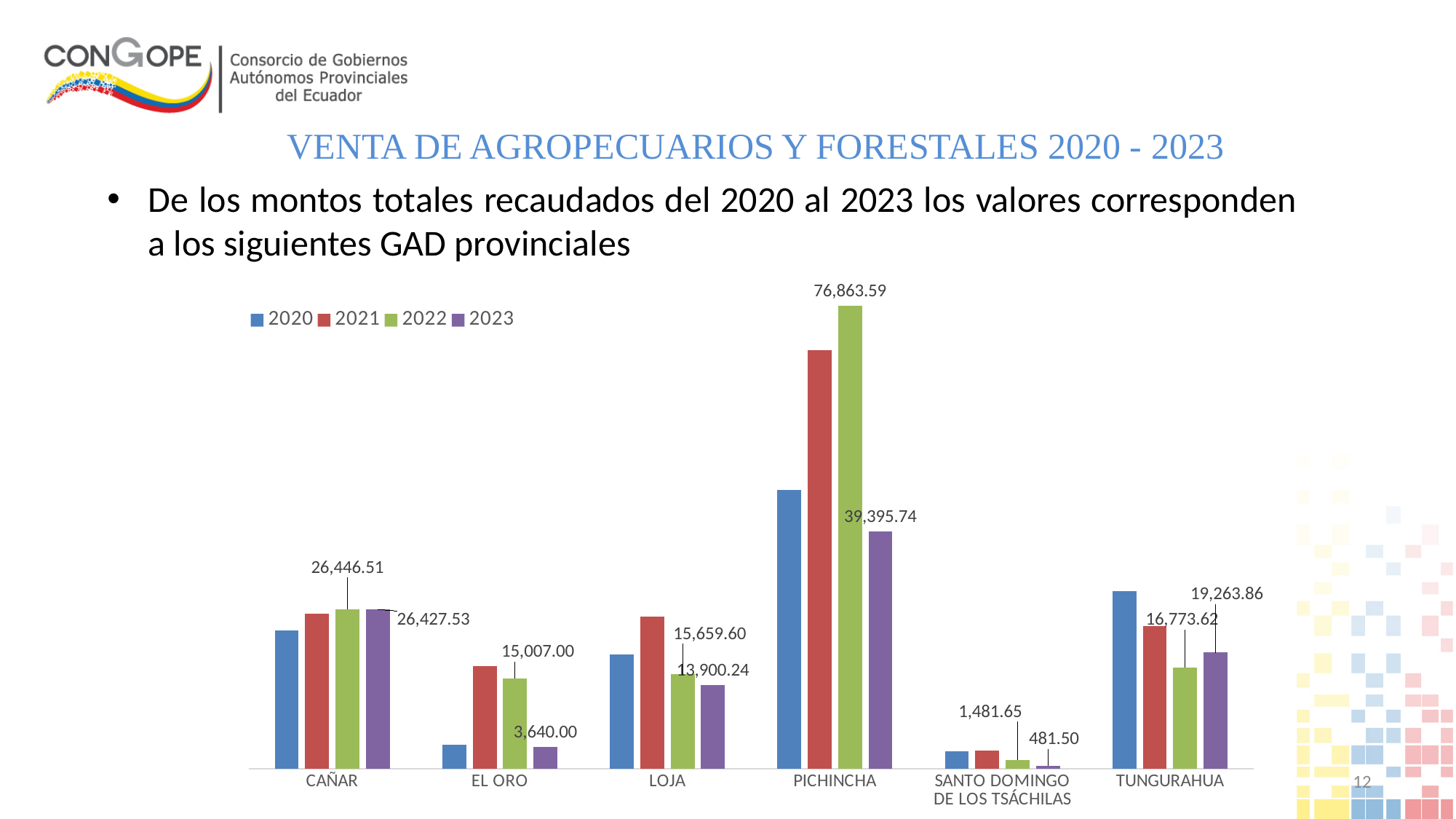
What is the 2023 value for Pichincha? 39,395.74 What is the 2022 value for Pichincha? 76,863.59 What is the 2023 value for El Oro? 3,640.00 Which colour represents the 2022 series in the legend? Green What is the difference between the 2022 and 2023 values for Pichincha? 37,467.85 What kind of chart is shown on the slide? Bar chart Which province has the lowest 2023 value? Santo Domingo de los Tsáchilas What is the 2023 value for Tungurahua? 19,263.86 Which province has the highest 2022 value? Pichincha What is the 2022 value for Santo Domingo de los Tsáchilas? 1,481.65 How many provinces (categories) are shown on the x axis? 6 How many series does the legend list? 4